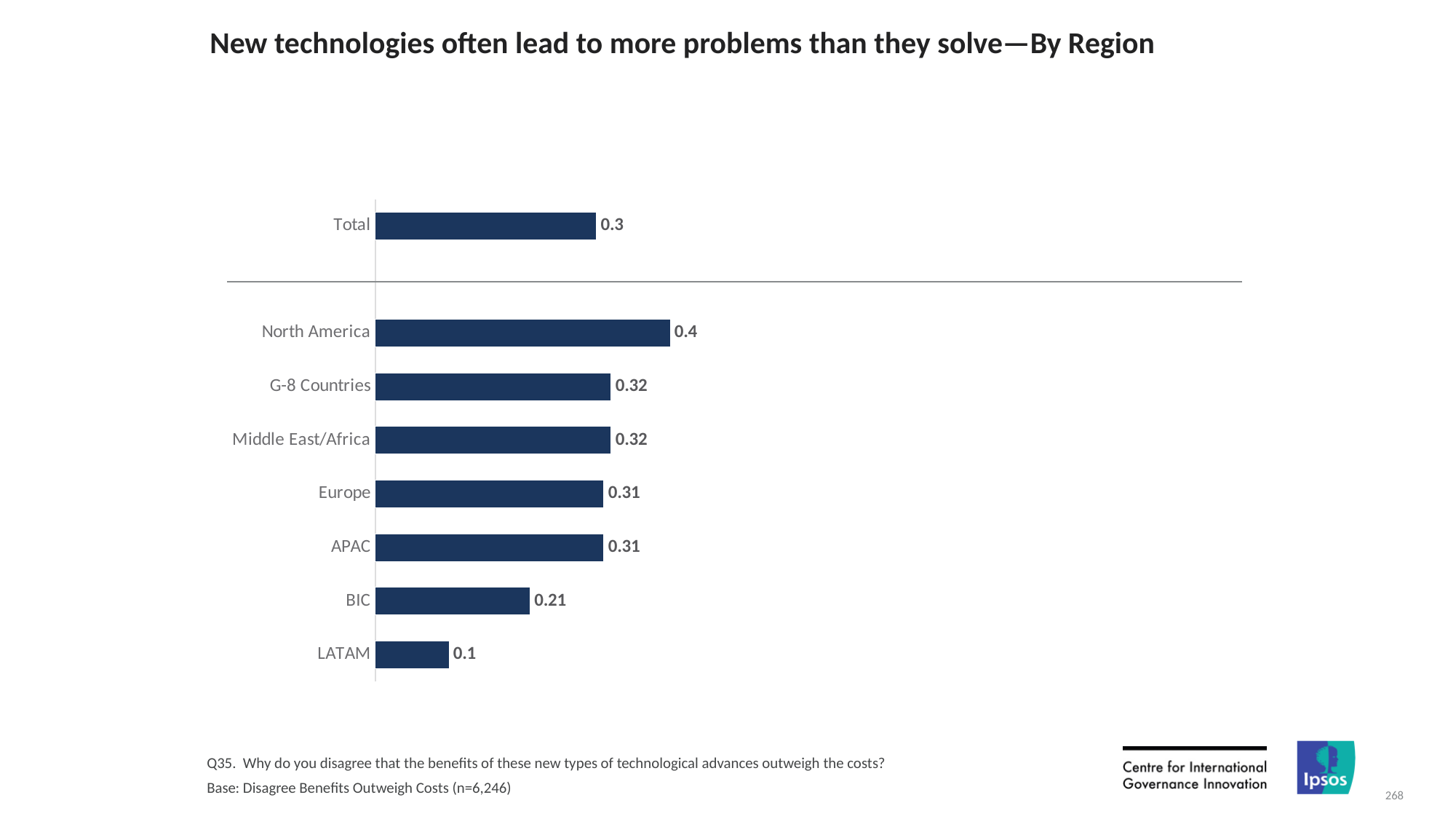
Which region has the lowest value? LATAM What is the title of the chart? New technologies often lead to more problems than they solve—By Region How many bars are shown on the chart, including Total? 8 What is the difference between the values for BIC and LATAM? 0.11 What is the difference between the values for North America and LATAM? 0.3 What is the value for North America? 0.4 What is the value for Total? 0.3 Which is larger, the value for Europe or the value for BIC? Europe What is the value for LATAM? 0.1 What is the value for BIC? 0.21 What kind of chart is shown on the slide? Bar chart Which region has the highest value? North America